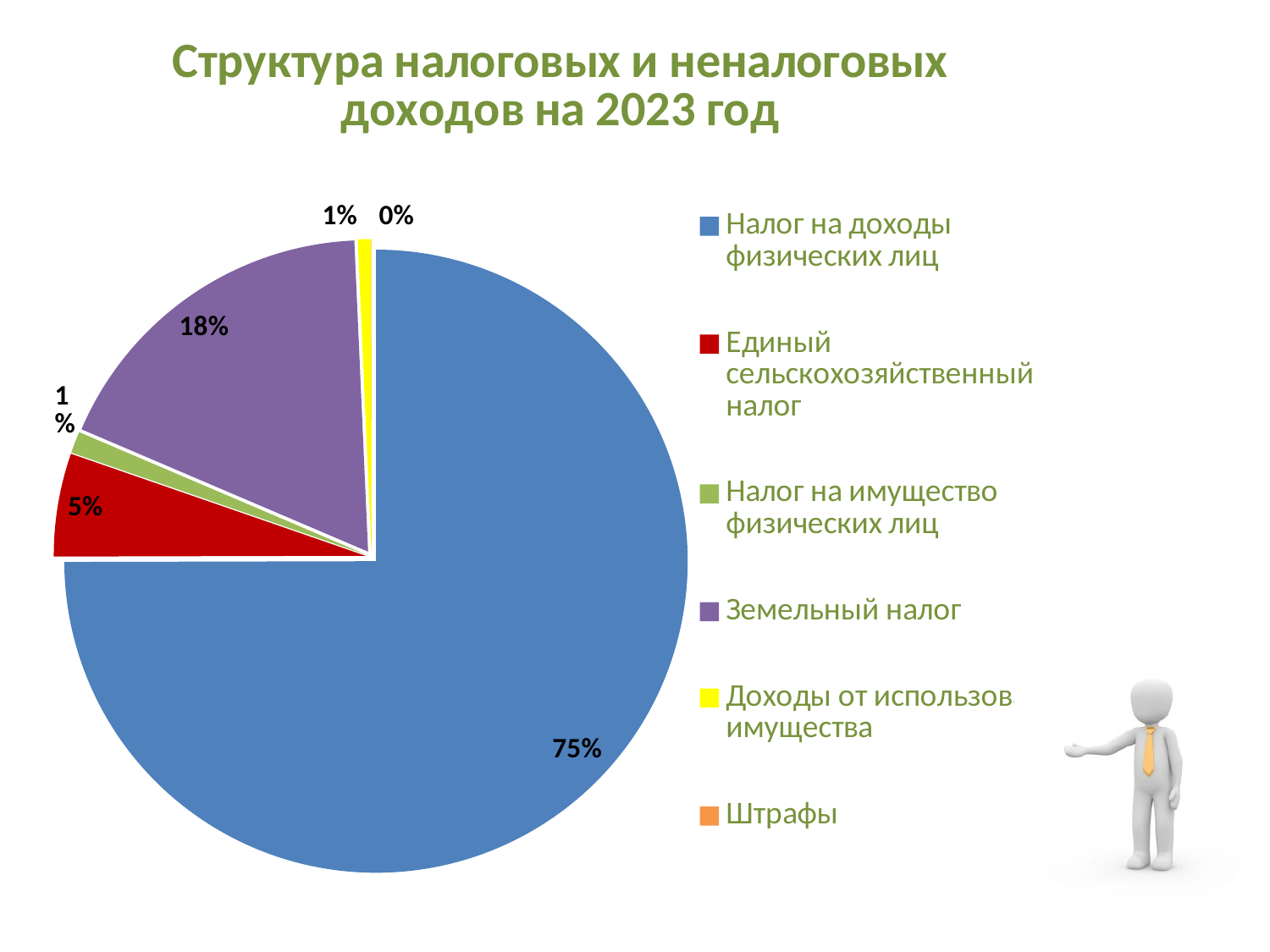
What share of the pie does Налог на доходы физических лиц have? 75% What share of the pie does Земельный налог have? 18% What is the difference in percentage points between Налог на доходы физических лиц and Земельный налог? 57% What share of the pie does Единый сельскохозяйственный налог have? 5% What is the title of the chart? Структура налоговых и неналоговых доходов на 2023 год How many categories does the legend list? 6 Which category has the largest share of the pie? Налог на доходы физических лиц What share of the pie does Налог на имущество физических лиц have? 1% What share of the pie does Штрафы have? 0% Which category has the smallest share of the pie? Штрафы What kind of chart is shown on the slide? Pie chart Which is larger: Земельный налог or Единый сельскохозяйственный налог? Земельный налог